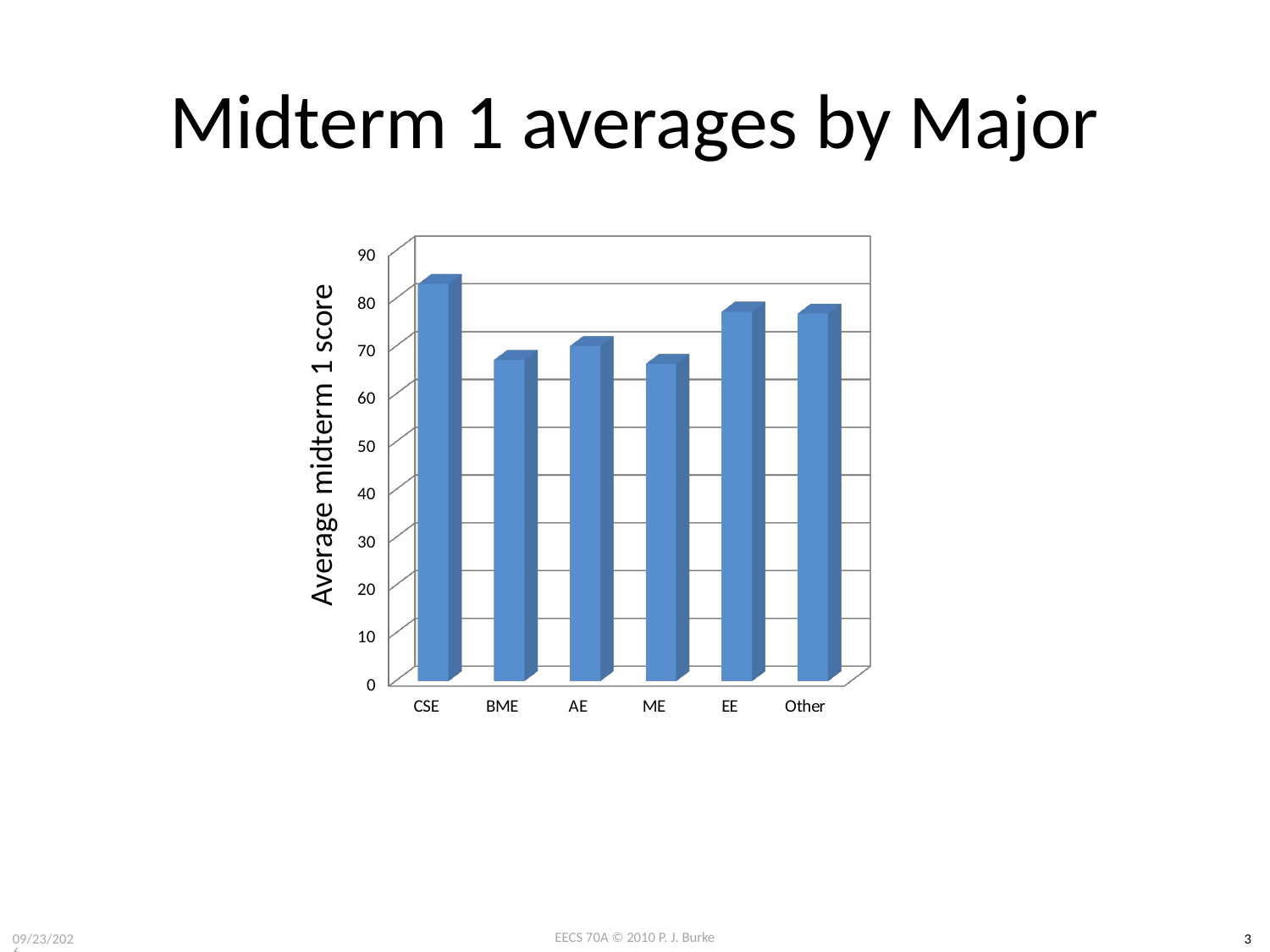
What is the label on the vertical axis of the chart? Average midterm 1 score Is the value for ME greater or less than 70? less What kind of chart is shown on the slide? bar chart What is the title of the chart? Midterm 1 averages by Major How many majors are shown on the x axis of the chart? 6 Is the value for Other greater or less than 70? greater Is the value for BME greater or less than 70? less Which has a higher average midterm 1 score, CSE or BME? CSE Which major has the highest average midterm 1 score? CSE Which has a higher average midterm 1 score, EE or ME? EE